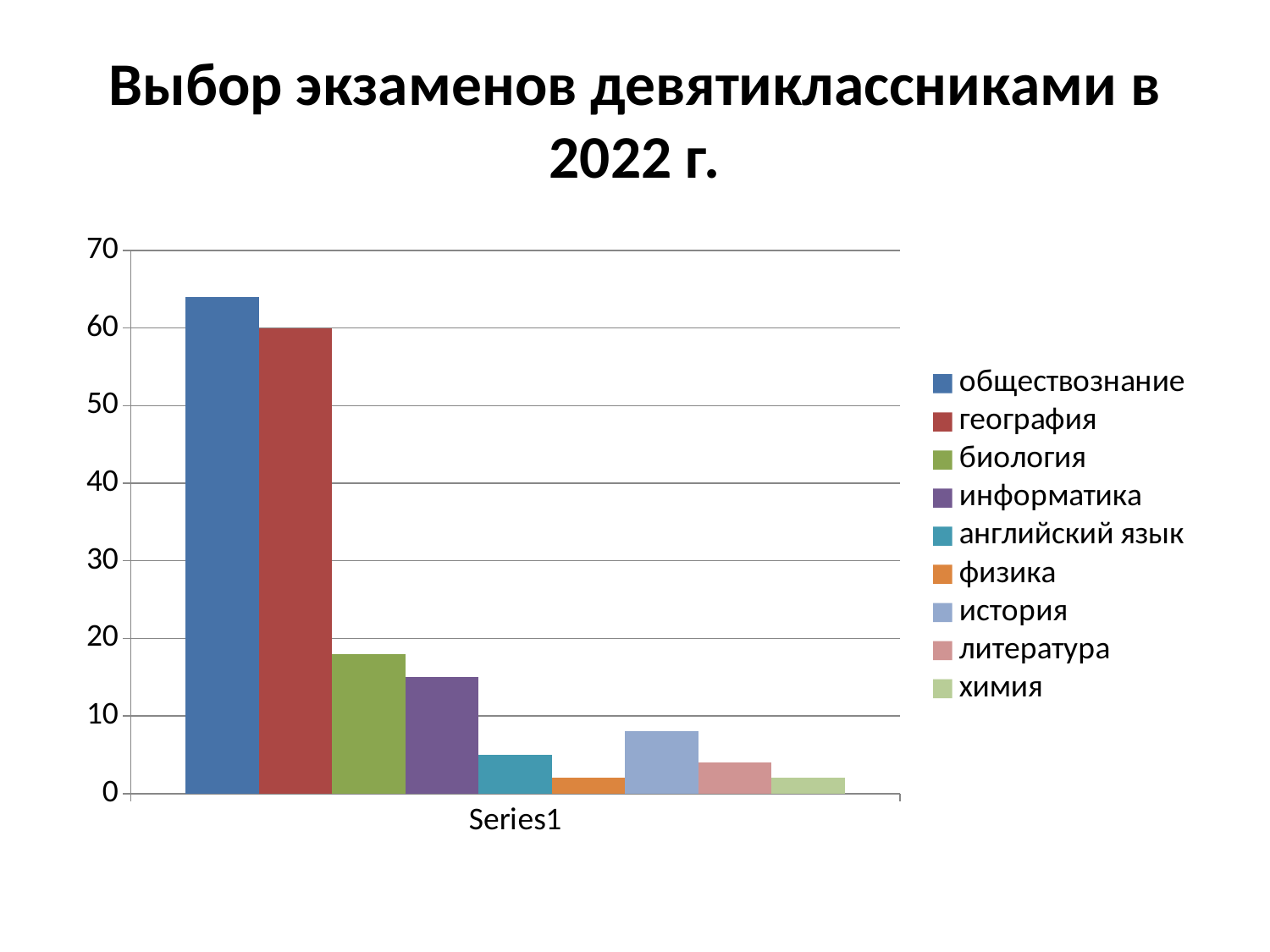
Is the value for история greater or less than 10? less Is the value for информатика greater or less than 10? greater What is the title of the chart? Выбор экзаменов девятиклассниками в 2022 г. Which subject has the highest bar? обществознание What type of chart is shown on the slide? bar chart Which is larger, the value for биология or the value for информатика? биология Is the value for обществознание greater or less than 60? greater How many entries does the legend list? 9 How many bars are plotted in the chart? 9 What is the value for география? 60 Which is larger, the value for история or the value for английский язык? история